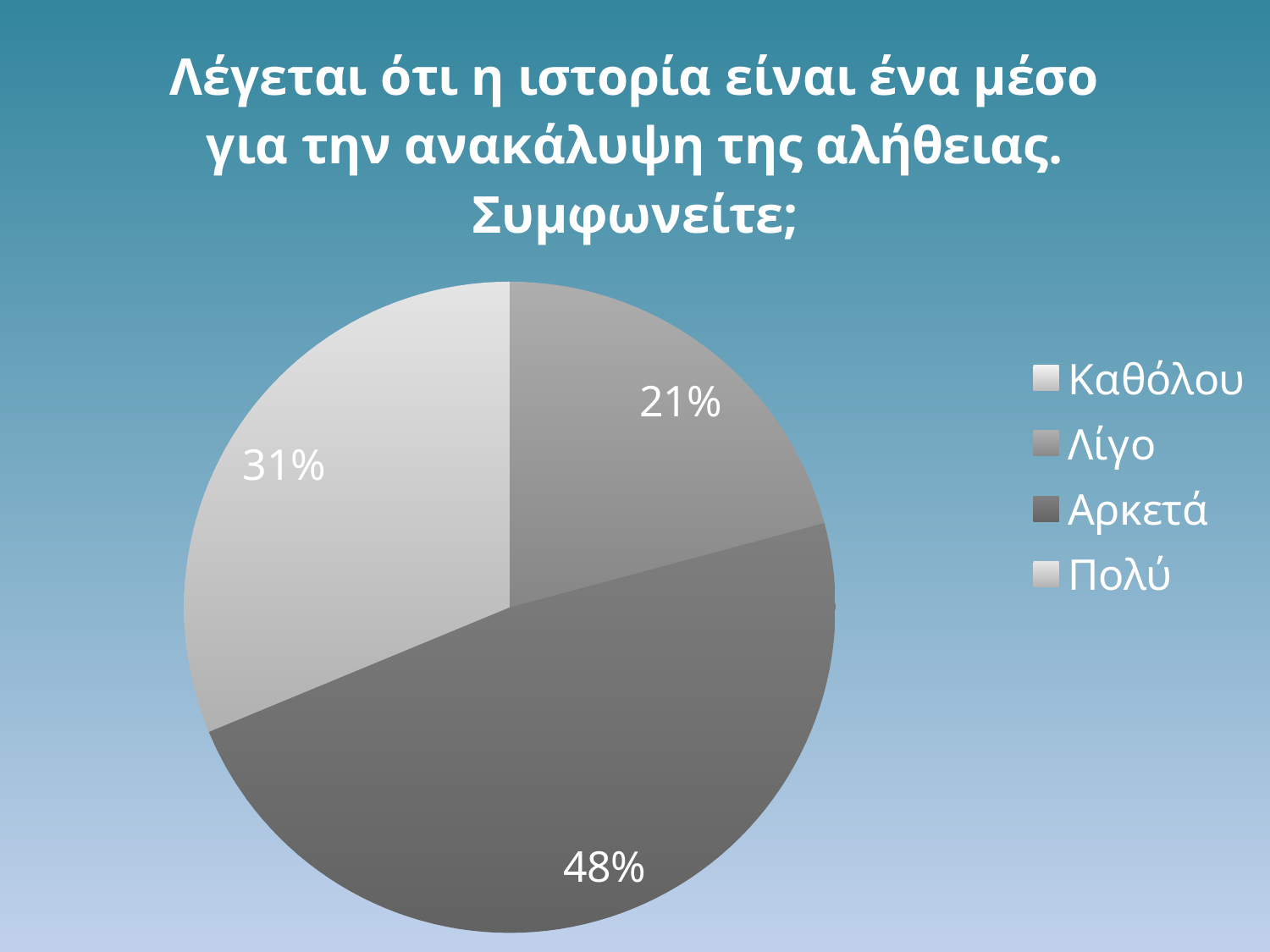
How many entries does the legend list? 4 How many slices have a percentage label printed on the pie? 3 What is the combined share of the Αρκετά and Πολύ slices? 79% What is the difference in percentage points between the Πολύ slice and the Λίγο slice? 10 Which of the labelled slices is the smallest? Λίγο What percentage of the pie is labelled for Αρκετά? 48% Which slice is larger, Πολύ or Λίγο? Πολύ Which category has the largest slice of the pie? Αρκετά What type of chart is shown on the slide? pie chart What percentage of the pie is labelled for Λίγο? 21% What percentage of the pie is labelled for Πολύ? 31% What is the difference in percentage points between the Αρκετά slice and the Πολύ slice? 17